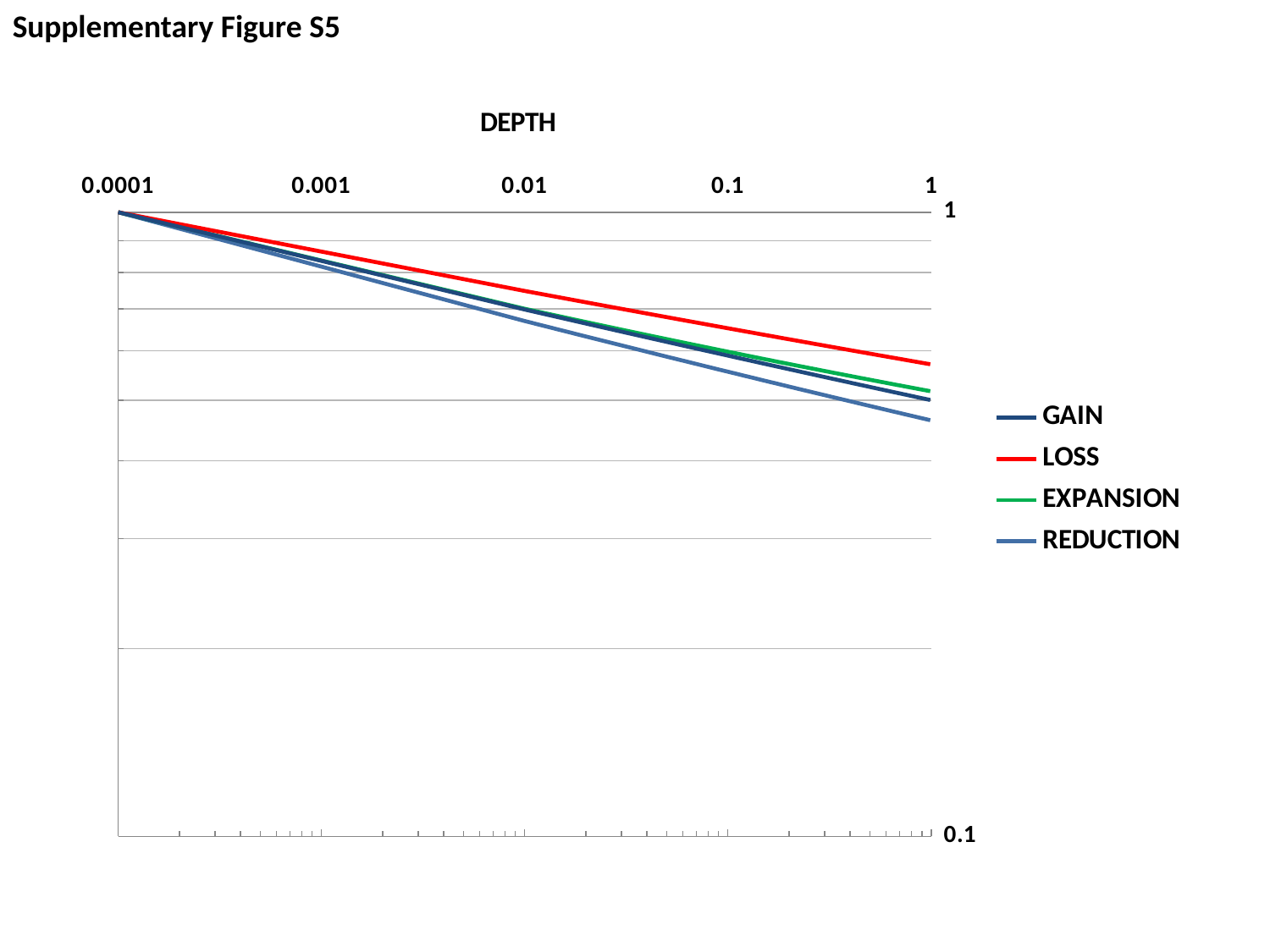
Which series has the highest value at DEPTH 1? LOSS How many tick labels are shown on the DEPTH axis? 5 What colour is the LOSS line in the legend? red Do the plotted values rise or fall as DEPTH increases from 0.0001 to 1? fall At DEPTH 1, which is larger, LOSS or GAIN? LOSS What kind of chart is shown on the slide? line chart At DEPTH 0.1, which is larger, LOSS or REDUCTION? LOSS How many series does the legend list? 4 What is the value of all four series at DEPTH 0.0001? 1 What is the title shown above the x axis of the chart? DEPTH Is the value for REDUCTION at DEPTH 1 greater or less than 0.1? greater Which series has the lowest value at DEPTH 1? REDUCTION